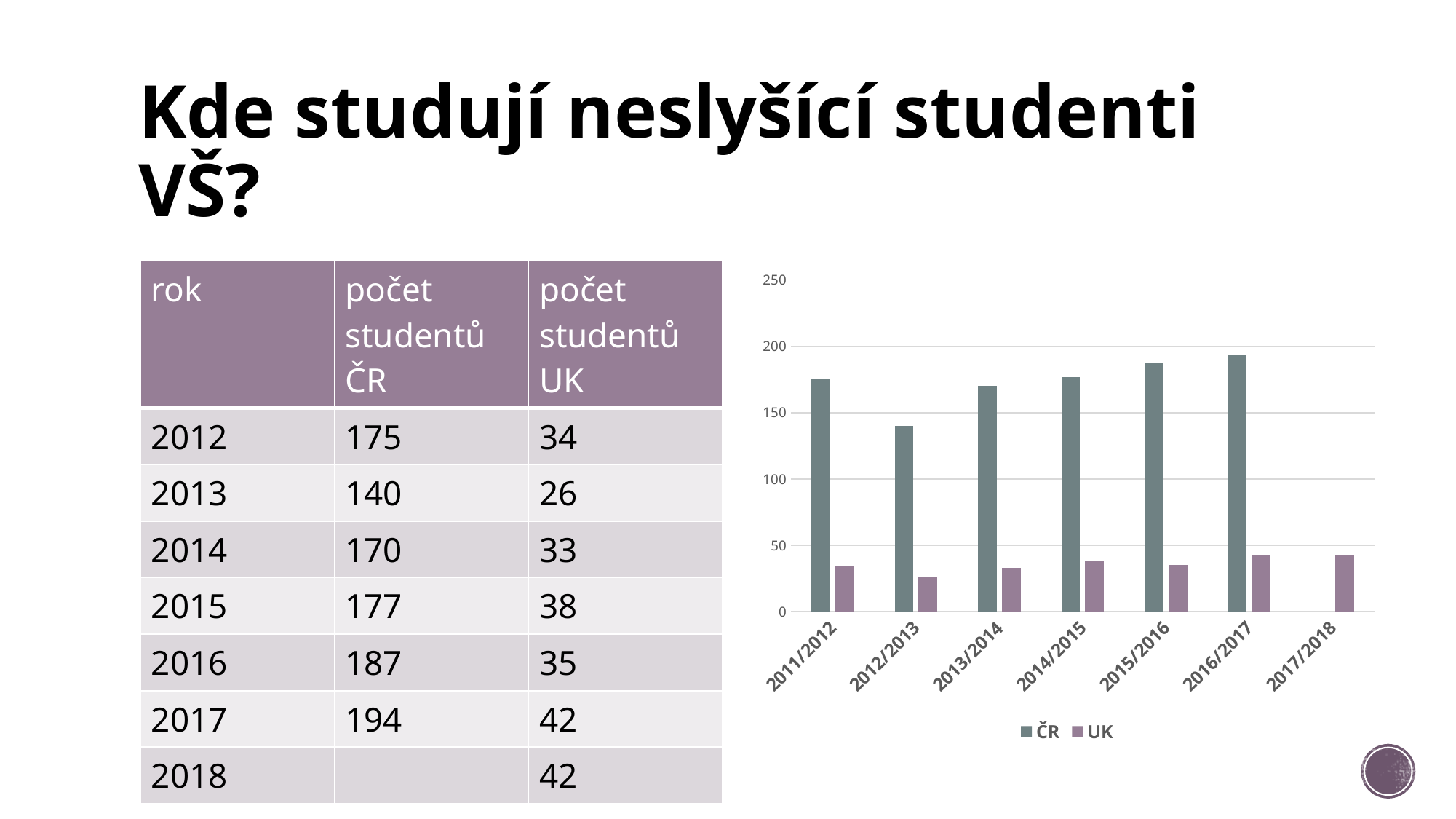
Is the ČR value for 2012/2013 greater or less than 150? less How many series does the chart legend list? 2 Is the UK value for 2016/2017 greater or less than 50? less Do the ČR values rise or fall from 2012/2013 to 2016/2017? rise Which academic year has the highest ČR bar in the chart? 2016/2017 In 2014/2015, which series has the larger value, ČR or UK? ČR How many academic-year categories are shown on the x axis of the chart? 7 Is the ČR value for 2016/2017 greater or less than 200? less What kind of chart is shown on the slide? bar chart Which academic year has the lowest ČR bar in the chart? 2012/2013 Which academic year has the lowest UK bar in the chart? 2012/2013